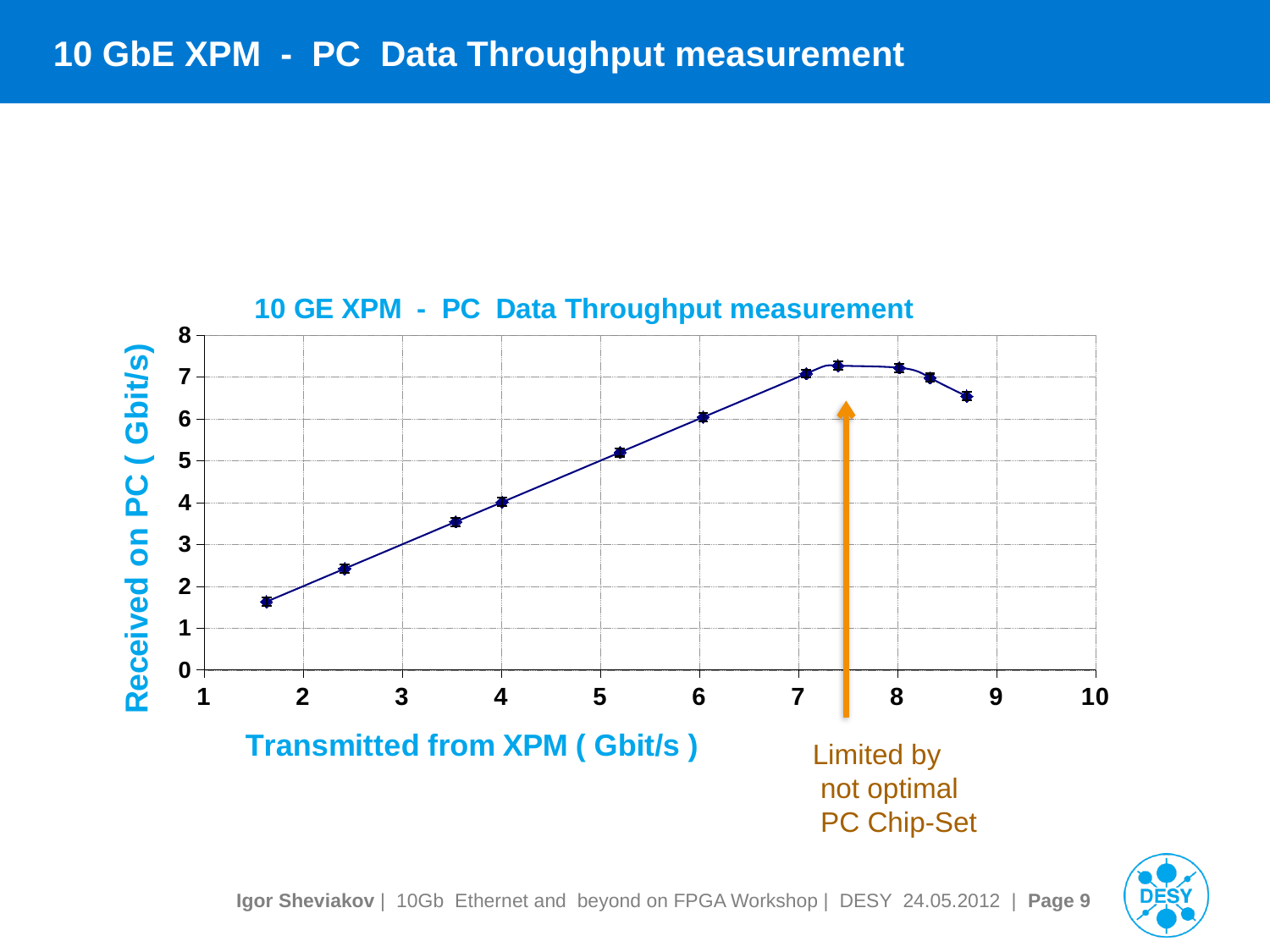
Is the value received on PC for the data point transmitted at about 6 Gbit/s greater or less than 5? greater Is the value received on PC for the data point transmitted at about 5.2 Gbit/s greater or less than 4? greater Does the received value rise or fall as the transmitted rate increases from about 7.4 to 8.7 Gbit/s? fall What is the label of the y axis of the chart? Received on PC ( Gbit/s ) Is the value received on PC for the data point transmitted at about 7.1 Gbit/s greater or less than 6? greater What is the title of the chart? 10 GE XPM - PC Data Throughput measurement What kind of chart is shown on the slide? line chart How many data points are plotted on the chart? 11 Which data point has the lowest received value on the chart? the first point, transmitted at about 1.6 Gbit/s Does the received value rise or fall as the transmitted rate increases from 1 to 7 Gbit/s? rise